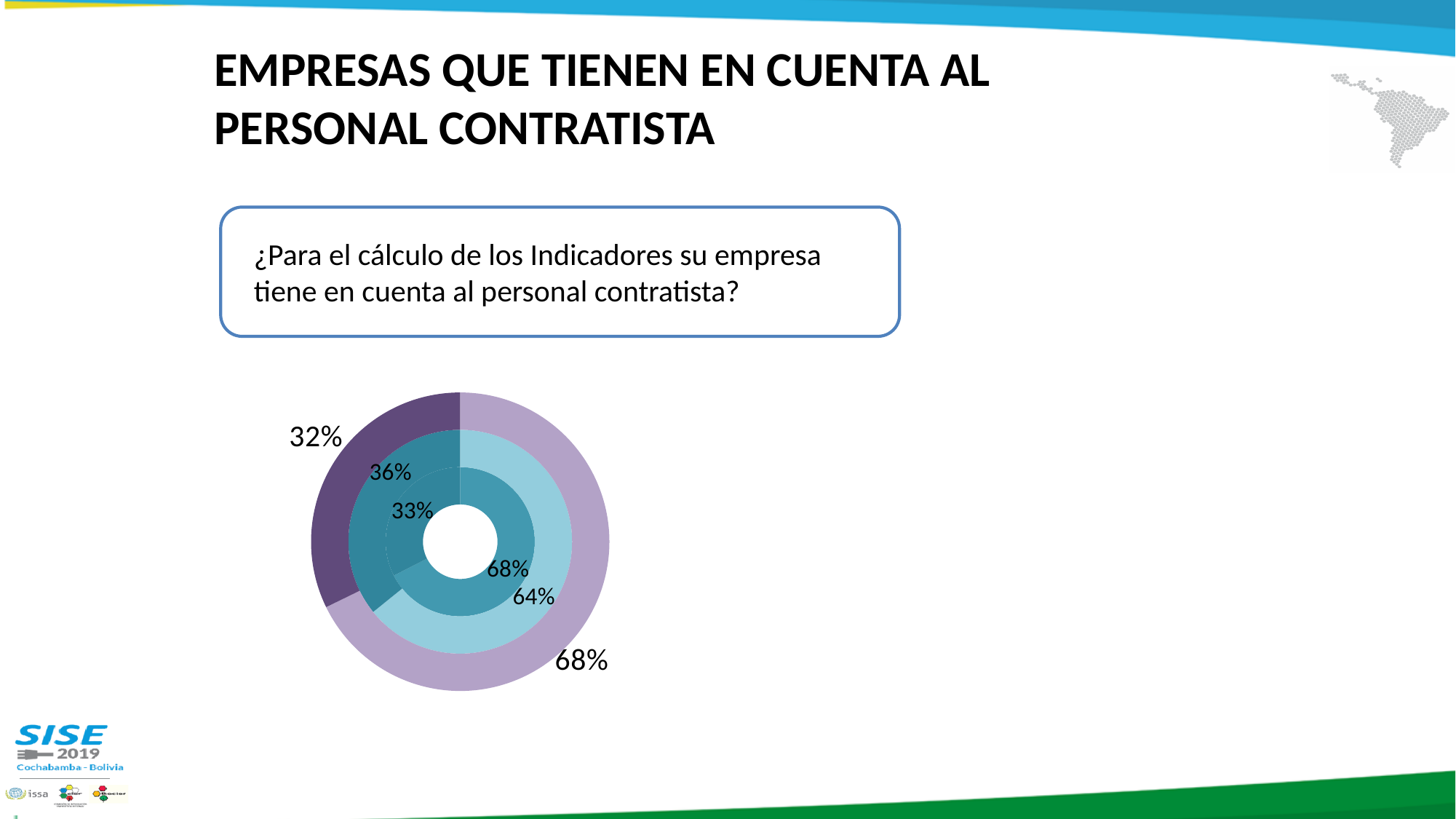
What is the difference between the two labelled values of the middle ring (64% and 36%)? 28 percentage points What value is labelled on the light purple slice of the outer ring? 68% What is the smaller value labelled on the innermost ring? 33% What is the smallest value labelled anywhere on the chart? 32% What value is labelled on the light blue slice of the middle ring? 64% What kind of chart is shown on the slide? Doughnut chart How many concentric rings does the doughnut chart have? 3 What is the difference between the two labelled values of the outer ring (68% and 32%)? 36 percentage points What value is labelled on the dark teal slice of the middle ring? 36% What value is labelled on the dark purple slice of the outer ring? 32% In the outer ring, which slice is larger, the dark purple one or the light purple one? The light purple one What survey question is shown in the box above the chart? ¿Para el cálculo de los Indicadores su empresa tiene en cuenta al personal contratista?